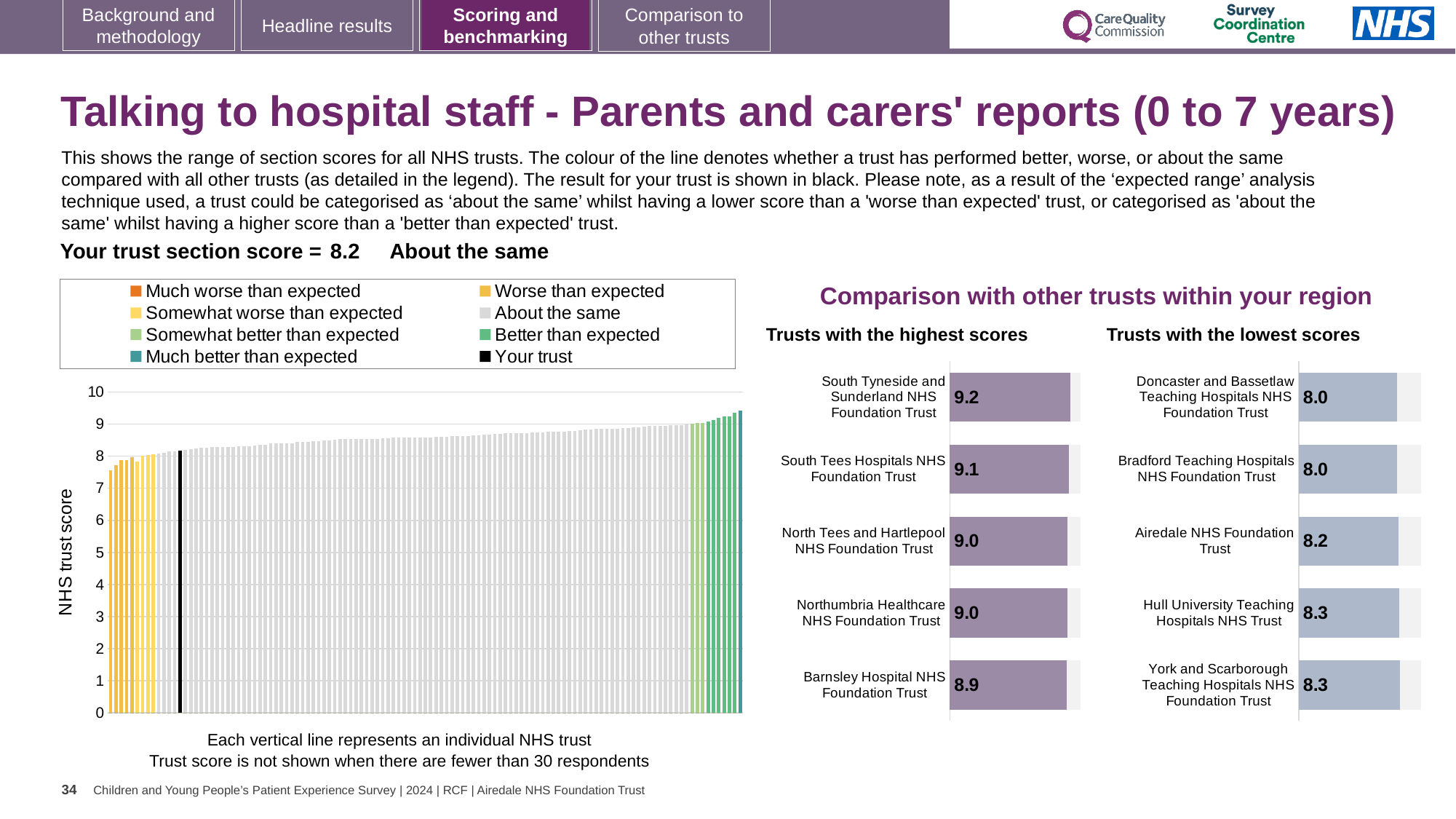
What kind of chart is the NHS trust score chart on the left of the slide? bar chart In the 'Trusts with the highest scores' chart, which trust has the lowest score? Barnsley Hospital NHS Foundation Trust In the NHS trust score chart on the left, do the values rise or fall from left to right? rise In the 'Trusts with the highest scores' chart, what is the difference between the scores of South Tyneside and Sunderland NHS Foundation Trust and Barnsley Hospital NHS Foundation Trust? 0.3 How many entries does the legend of the NHS trust score chart on the left list? 8 In the 'Trusts with the highest scores' chart, what is the score for South Tyneside and Sunderland NHS Foundation Trust? 9.2 What is the y-axis label of the chart on the left of the slide? NHS trust score In the 'Trusts with the highest scores' chart, which trust has the highest score? South Tyneside and Sunderland NHS Foundation Trust In the 'Trusts with the lowest scores' chart, what is the score for Airedale NHS Foundation Trust? 8.2 In the 'Trusts with the lowest scores' chart, which has the larger score: Hull University Teaching Hospitals NHS Trust or Doncaster and Bassetlaw Teaching Hospitals NHS Foundation Trust? Hull University Teaching Hospitals NHS Trust How many trusts are shown in the 'Trusts with the lowest scores' chart? 5 What is the section score for your trust shown on the slide? 8.2